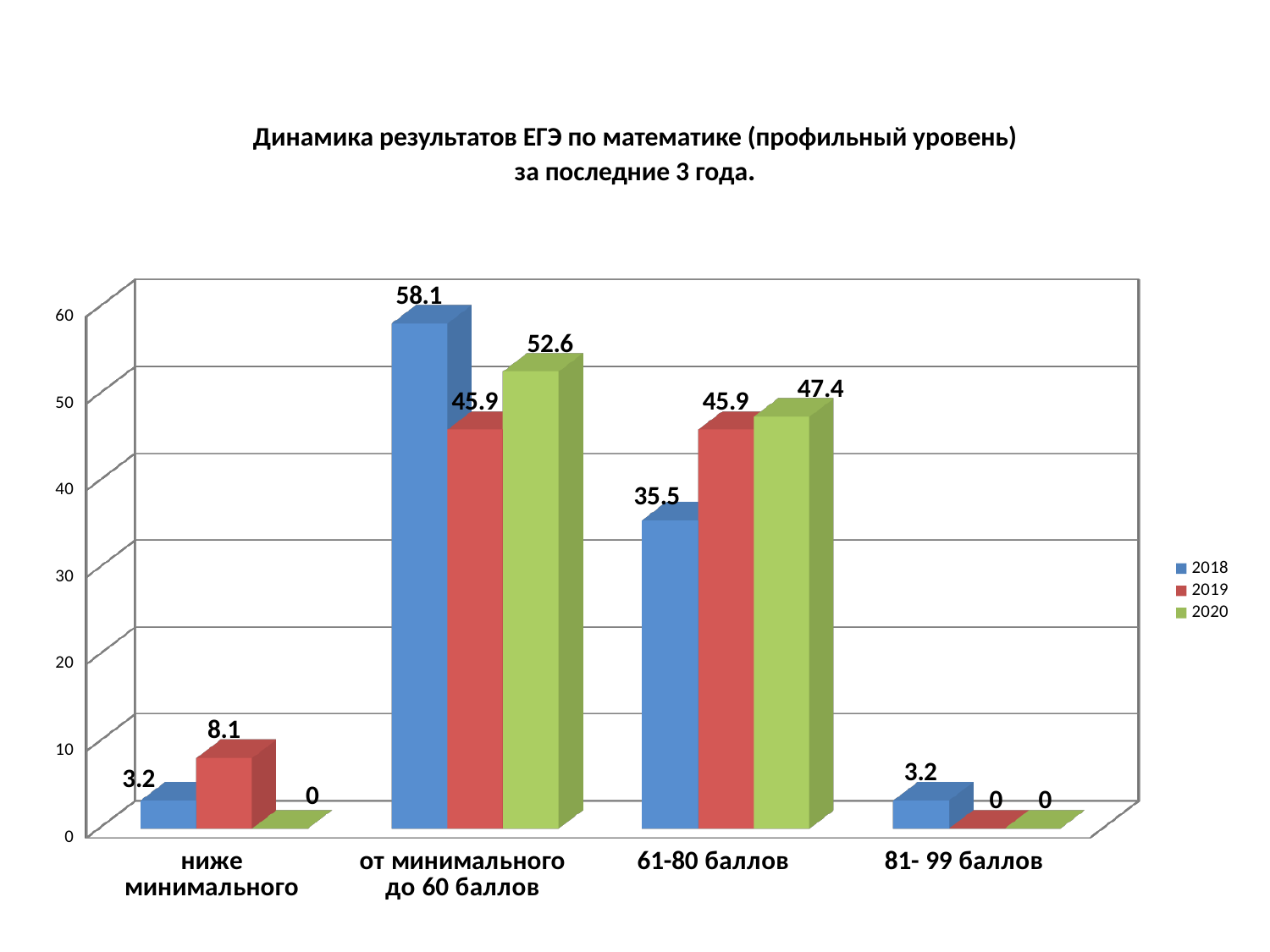
What kind of chart is shown on the slide? bar chart What is the value for 2020 in the category "61-80 баллов"? 47.4 Which series is shown in green in the legend? 2020 Which is larger in the category "61-80 баллов": the 2018 value or the 2019 value? 2019 How many categories are shown on the x axis? 4 What is the value for 2018 in the category "от минимального до 60 баллов"? 58.1 Which category has the highest value for the 2018 series? от минимального до 60 баллов What is the value for 2019 in the category "ниже минимального"? 8.1 How many series does the legend list? 3 What is the difference between the 2018 and 2019 values in the category "от минимального до 60 баллов"? 12.2 What is the difference between the 2020 and 2019 values in the category "61-80 баллов"? 1.5 Which category has the lowest value for the 2019 series? 81- 99 баллов